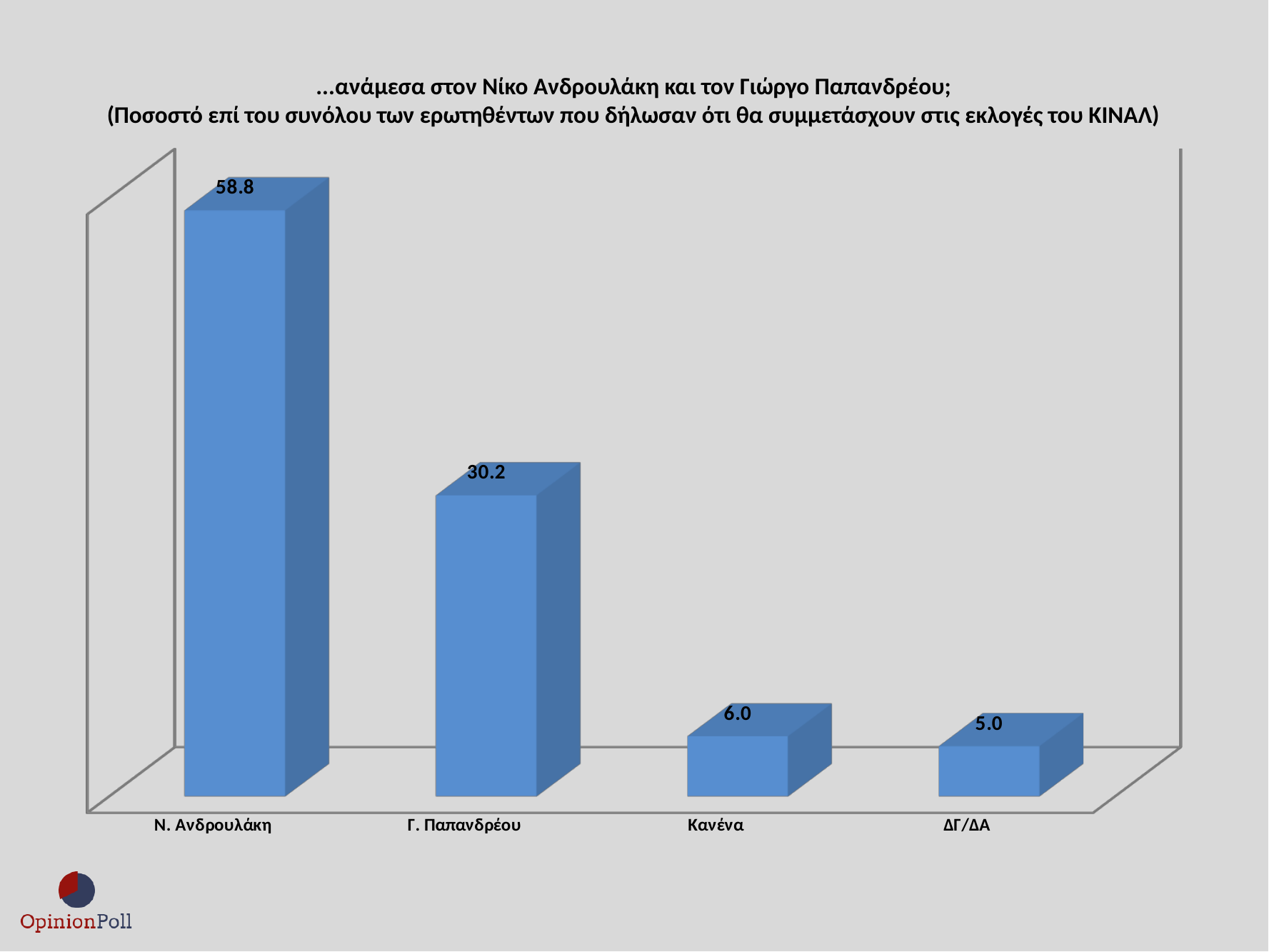
What kind of chart is this? bar chart What is the difference between the values for Κανένα and ΔΓ/ΔΑ? 1.0 What is the value for Κανένα? 6.0 What is the value for Ν. Ανδρουλάκη? 58.8 Do the values rise or fall from left to right along the x axis? fall Which category has the highest value? Ν. Ανδρουλάκη What is the value for Γ. Παπανδρέου? 30.2 What is the difference between the values for Ν. Ανδρουλάκη and Γ. Παπανδρέου? 28.6 How many categories are shown on the x axis? 4 Which is larger, the value for Γ. Παπανδρέου or the value for Κανένα? Γ. Παπανδρέου What is the value for ΔΓ/ΔΑ? 5.0 Which category has the lowest value? ΔΓ/ΔΑ